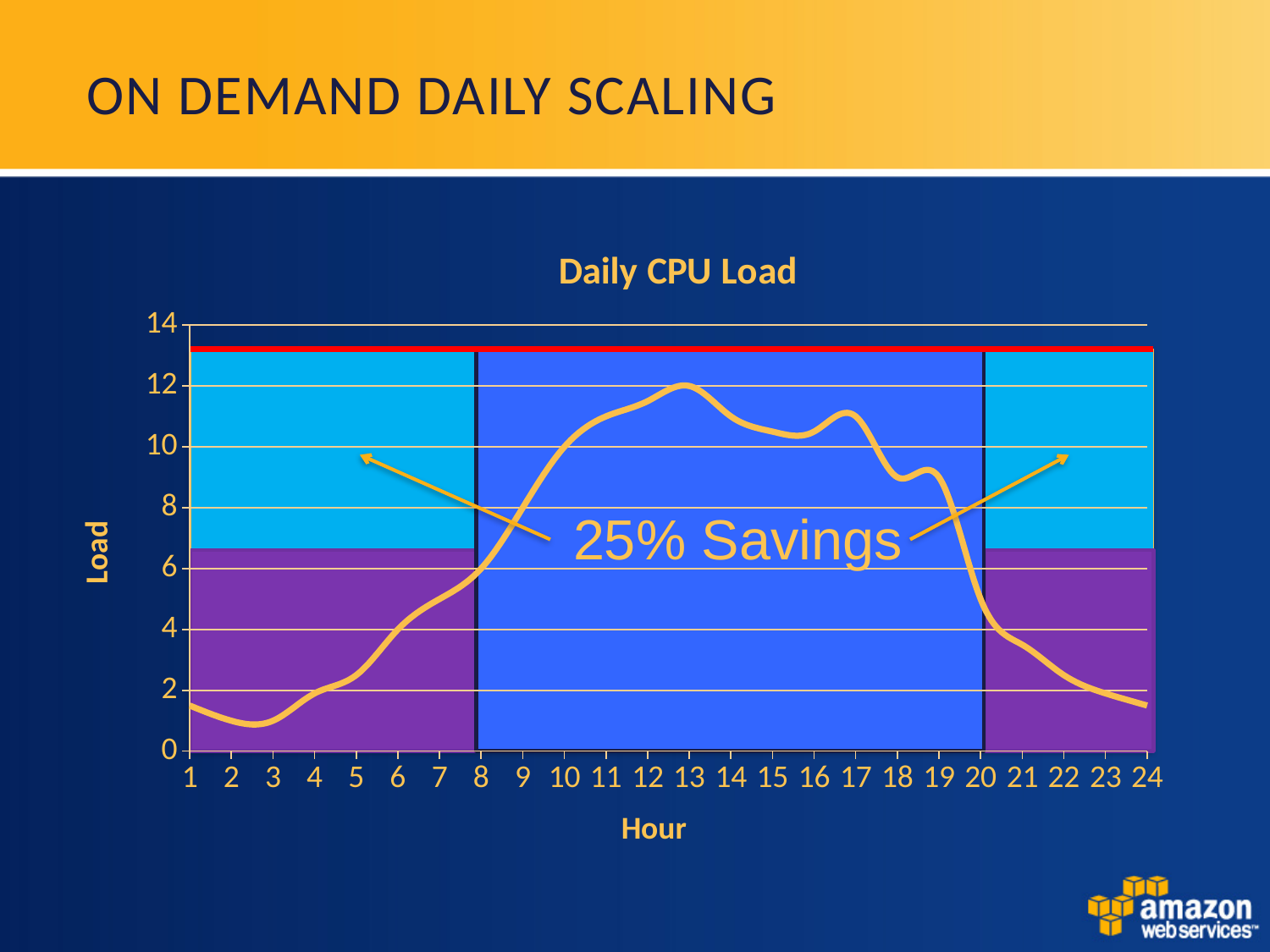
Is the load at hour 20 greater or less than 6? less Is the load at hour 13 greater or less than 10? greater What kind of chart is shown on the slide? line chart What is the label of the x axis? Hour Does the CPU load rise or fall between hour 17 and hour 24? fall At which hour does the CPU load reach its highest value? 13 What is the title of the chart? Daily CPU Load Does the CPU load rise or fall between hour 1 and hour 13? rise Is the load at hour 3 greater or less than 2? less Which hour has a higher load, hour 13 or hour 24? 13 How many hours are plotted along the x axis of the Daily CPU Load chart? 24